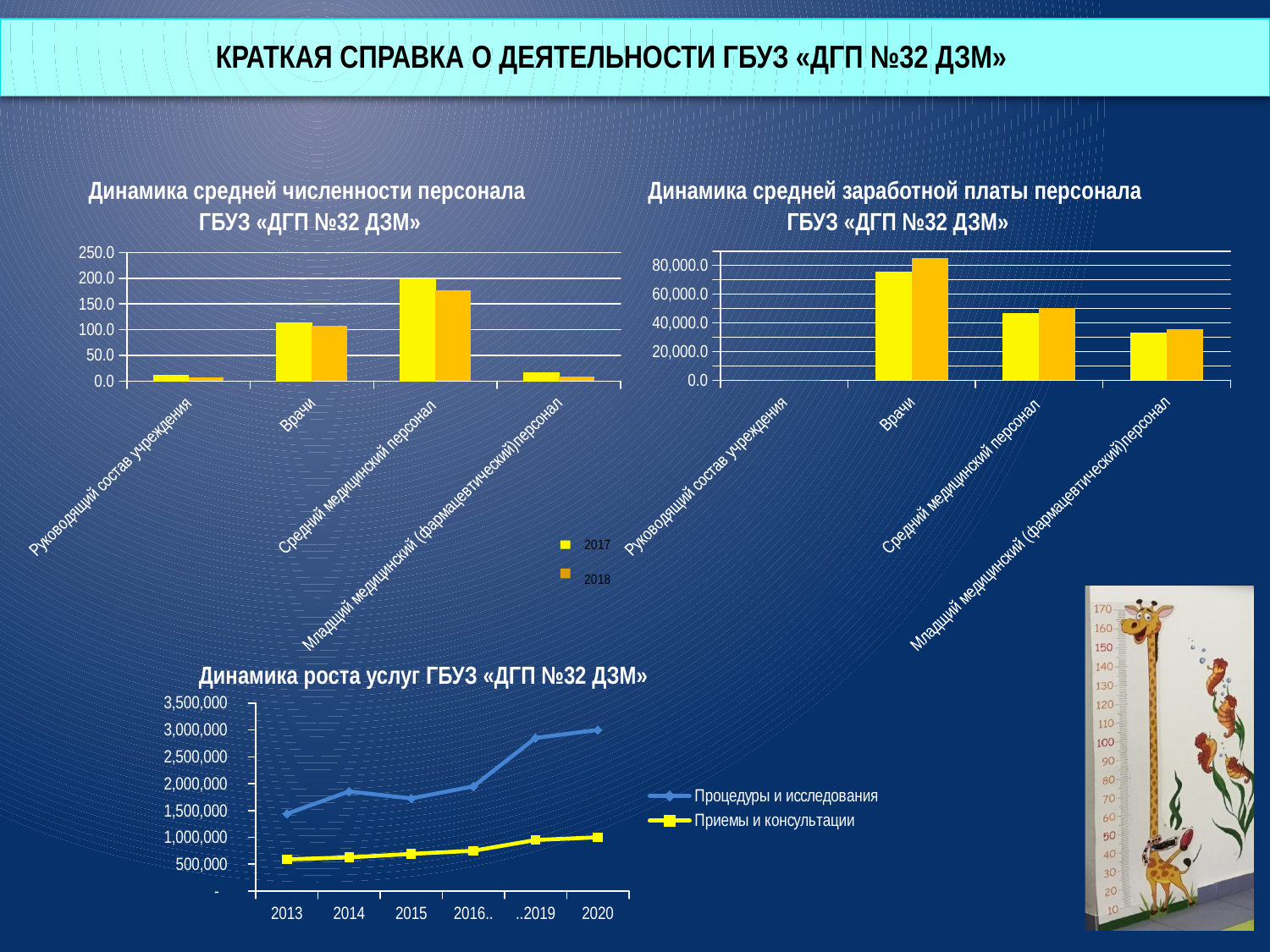
In the 'Динамика средней численности персонала' chart, is the 2017 value for Врачи greater or less than 100.0? greater In the 'Динамика средней заработной платы персонала' chart, which category has the highest salary values? Врачи How many series does the legend of the 'Динамика роста услуг' chart list? 2 In the 'Динамика роста услуг' chart, which series has the higher values across all years? Процедуры и исследования In the 'Динамика средней численности персонала' chart, which is larger for Средний медицинский персонал: the 2017 value or the 2018 value? 2017 In the 'Динамика средней заработной платы персонала' chart, is the 2018 value for Врачи greater or less than 80,000.0? greater In the 'Динамика средней численности персонала' chart, is the 2018 value for Средний медицинский персонал greater or less than 200.0? less What kind of chart is the 'Динамика средней заработной платы персонала' chart? bar chart What kind of chart is the 'Динамика роста услуг' chart? line chart What kind of chart is the 'Динамика средней численности персонала' chart? bar chart In the 'Динамика средней численности персонала' chart, which category has the highest values? Средний медицинский персонал How many categories are shown on the x axis of the 'Динамика средней численности персонала' chart? 4